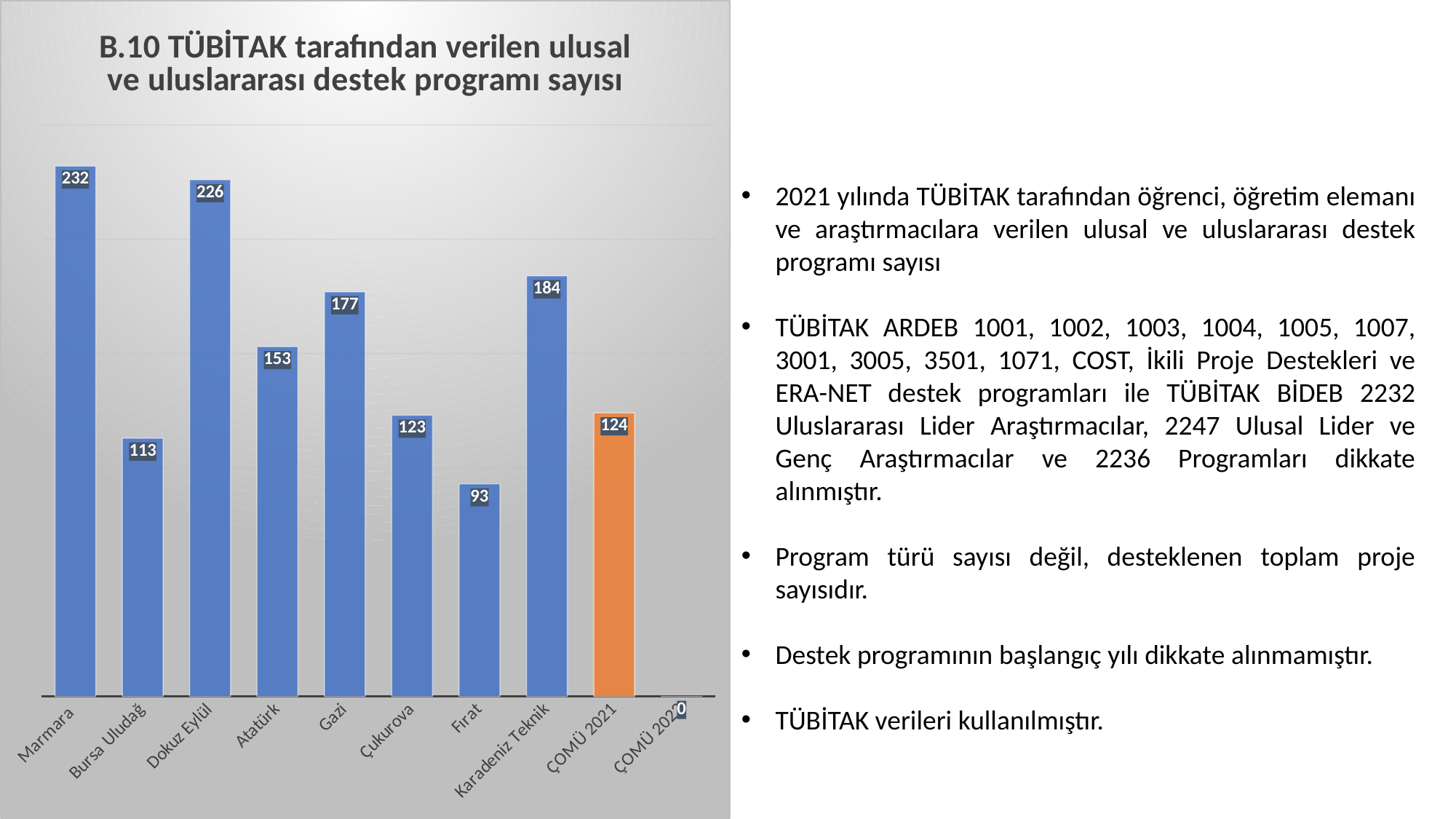
What is the value for Karadeniz Teknik? 184 What is the value for Bursa Uludağ? 113 Which is larger, the value for Çukurova or the value for ÇOMÜ 2021? ÇOMÜ 2021 What is the value for ÇOMÜ 2021? 124 What is the difference between the values for Gazi and Atatürk? 24 Which category has the highest value? Marmara Which is larger, the value for Gazi or the value for Karadeniz Teknik? Karadeniz Teknik What is the value for Marmara? 232 What is the difference between the values for Marmara and Dokuz Eylül? 6 Which bar is coloured orange rather than blue? ÇOMÜ 2021 What kind of chart is shown on the slide? Bar chart Which of the named universities (excluding the zero bar) has the lowest value? Fırat